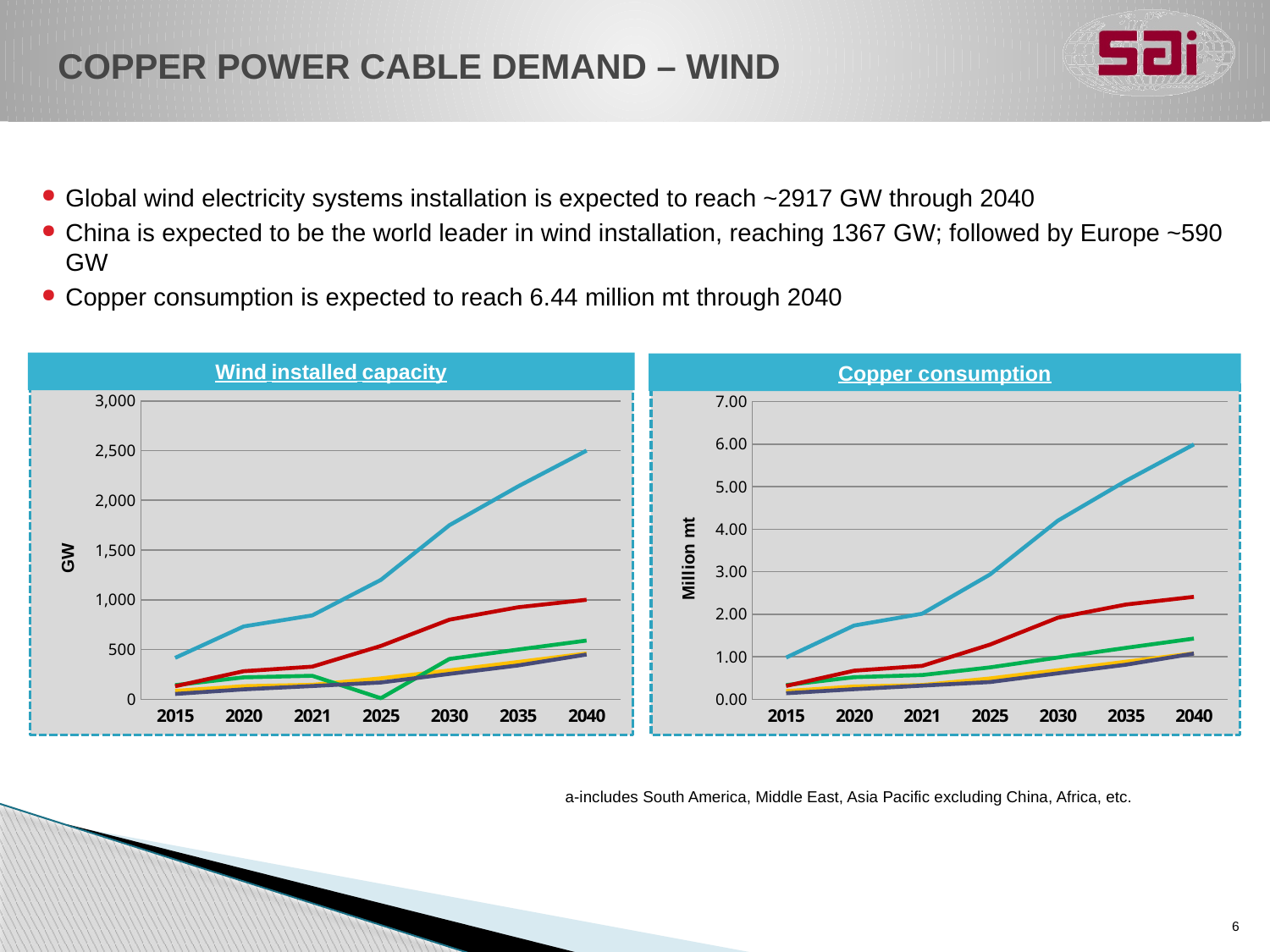
In the Copper consumption chart, is the value of the light blue line in 2015 greater or less than 2.00? less In the Wind installed capacity chart, which line is higher in 2040, the light blue line or the red line? the light blue line In the Copper consumption chart, is the value of the red line in 2040 greater or less than 3.00? less What kind of chart is the Copper consumption chart? line chart What kind of chart is the Wind installed capacity chart? line chart What is the y-axis title of the Copper consumption chart? Million mt In the Wind installed capacity chart, is the value of the light blue line in 2040 greater or less than 2,000? greater What is the y-axis title of the Wind installed capacity chart? GW How many years are shown on the x axis of the Wind installed capacity chart? 7 In the Wind installed capacity chart, does the light blue line rise or fall from 2015 to 2040? rise